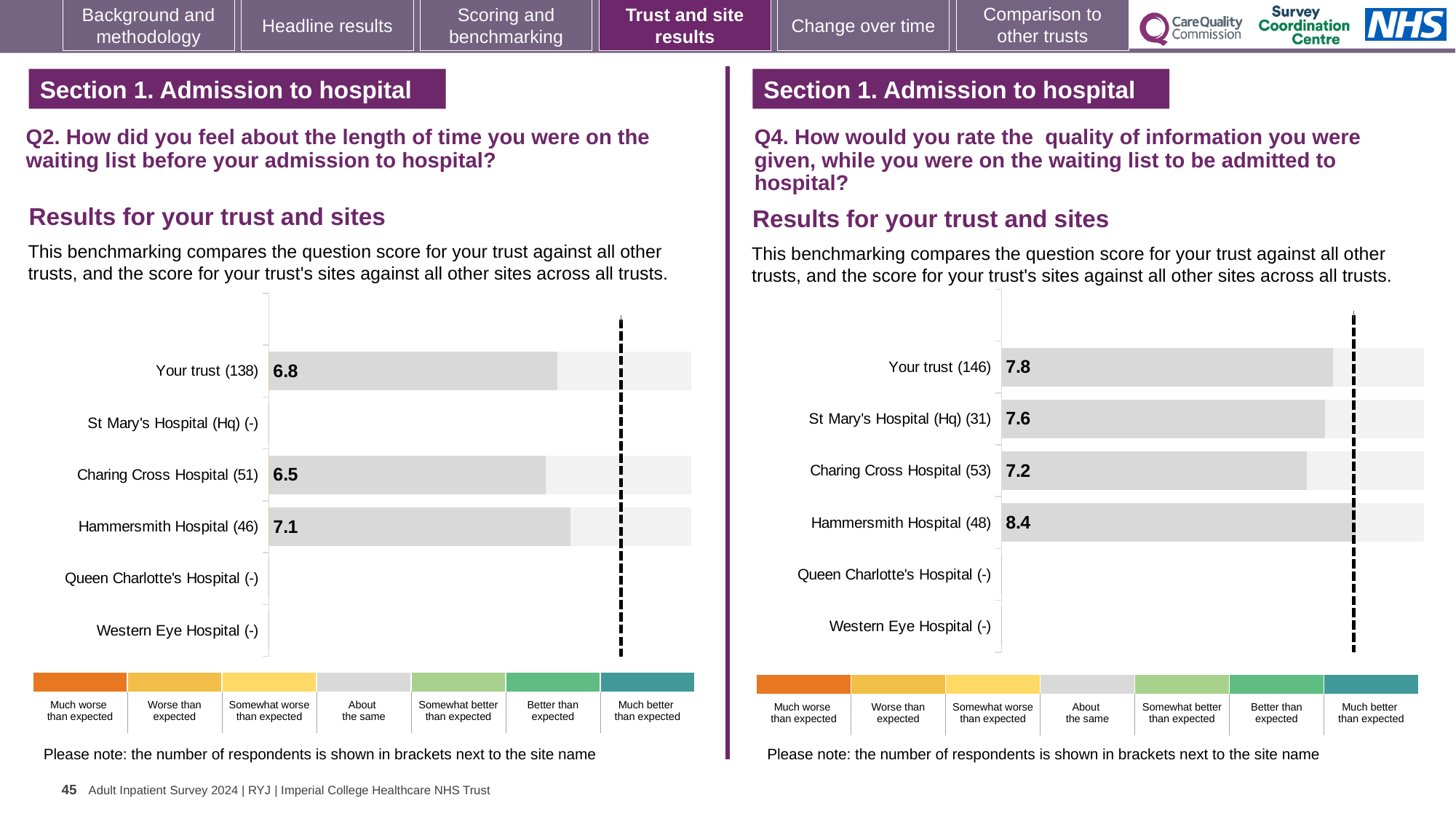
In the Q4 chart (right), what is the difference between the Hammersmith Hospital score and the Your trust score? 0.6 In the Q2 chart (left), what is the score for Hammersmith Hospital? 7.1 In the Q4 chart (right), how many respondents are shown in brackets for Hammersmith Hospital? 48 In the Q2 chart (left), what is the score for Your trust? 6.8 In the Q4 chart (right), what is the score for Charing Cross Hospital? 7.2 In the Q2 chart (left), what is the difference between the Hammersmith Hospital score and the Charing Cross Hospital score? 0.6 In the Q4 chart (right), which site has the highest score? Hammersmith Hospital How many site/trust categories are listed on the y axis of the Q2 chart (left)? 6 In the Q2 chart (left), which site with a plotted score has the lowest value? Charing Cross Hospital In the Q4 chart (right), what is the score for St Mary's Hospital (Hq)? 7.6 In the Q4 chart (right), which is larger: the score for Your trust or the score for Charing Cross Hospital? Your trust What kind of chart is used for the Q4 results (right)? Bar chart